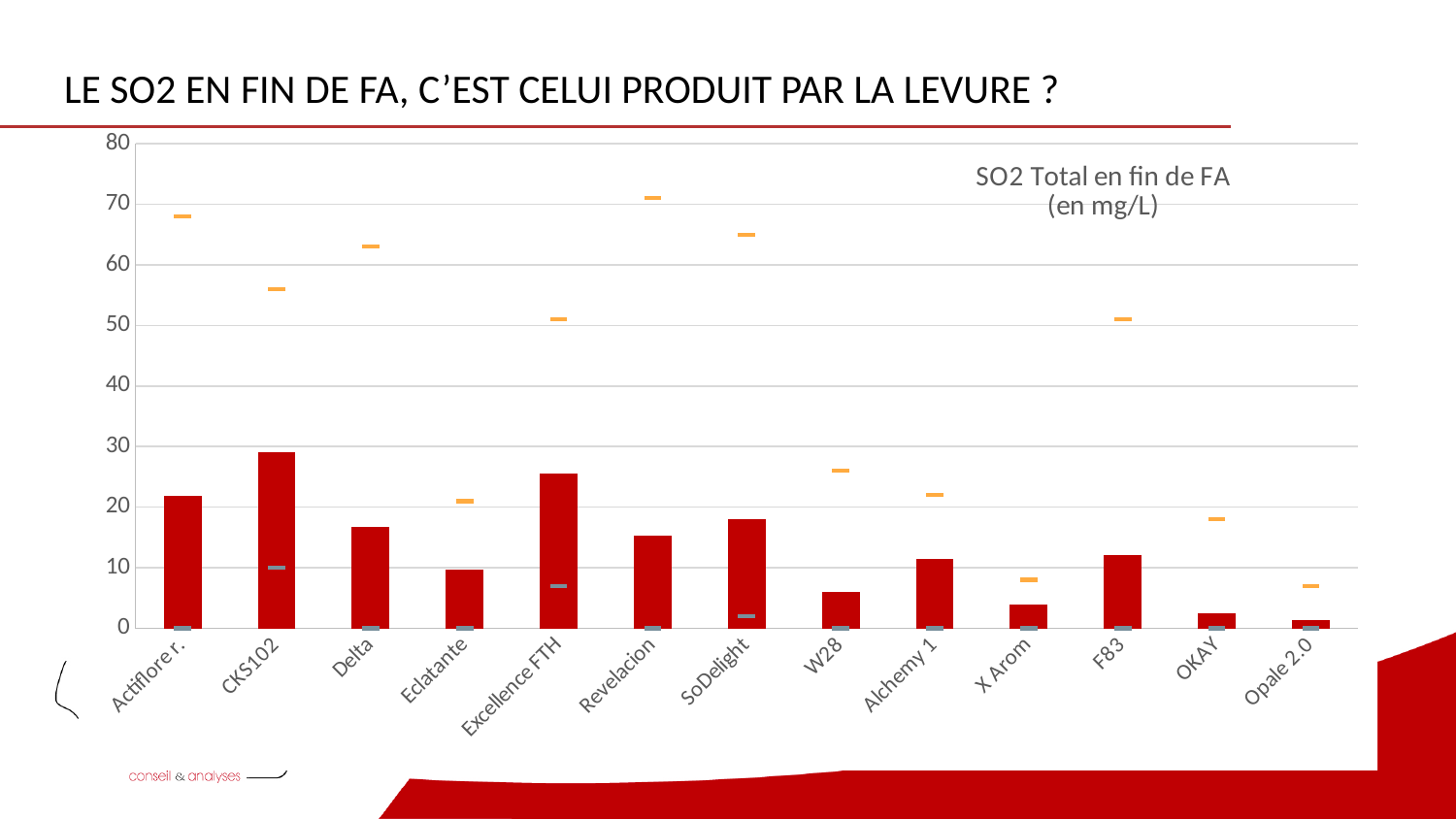
Which has the taller red bar, Actiflore r. or Revelacion? Actiflore r. Which has the taller red bar, CKS102 or Delta? CKS102 Is the red bar for Excellence FTH greater or less than 20? greater Is the red bar for W28 greater or less than 10? less Is the orange marker for SoDelight greater or less than 60? greater Which category has the tallest red bar? CKS102 What is the title of the chart? SO2 Total en fin de FA (en mg/L) What kind of chart is shown on the slide? bar chart How many yeast strains (categories) are shown on the x axis of the chart? 13